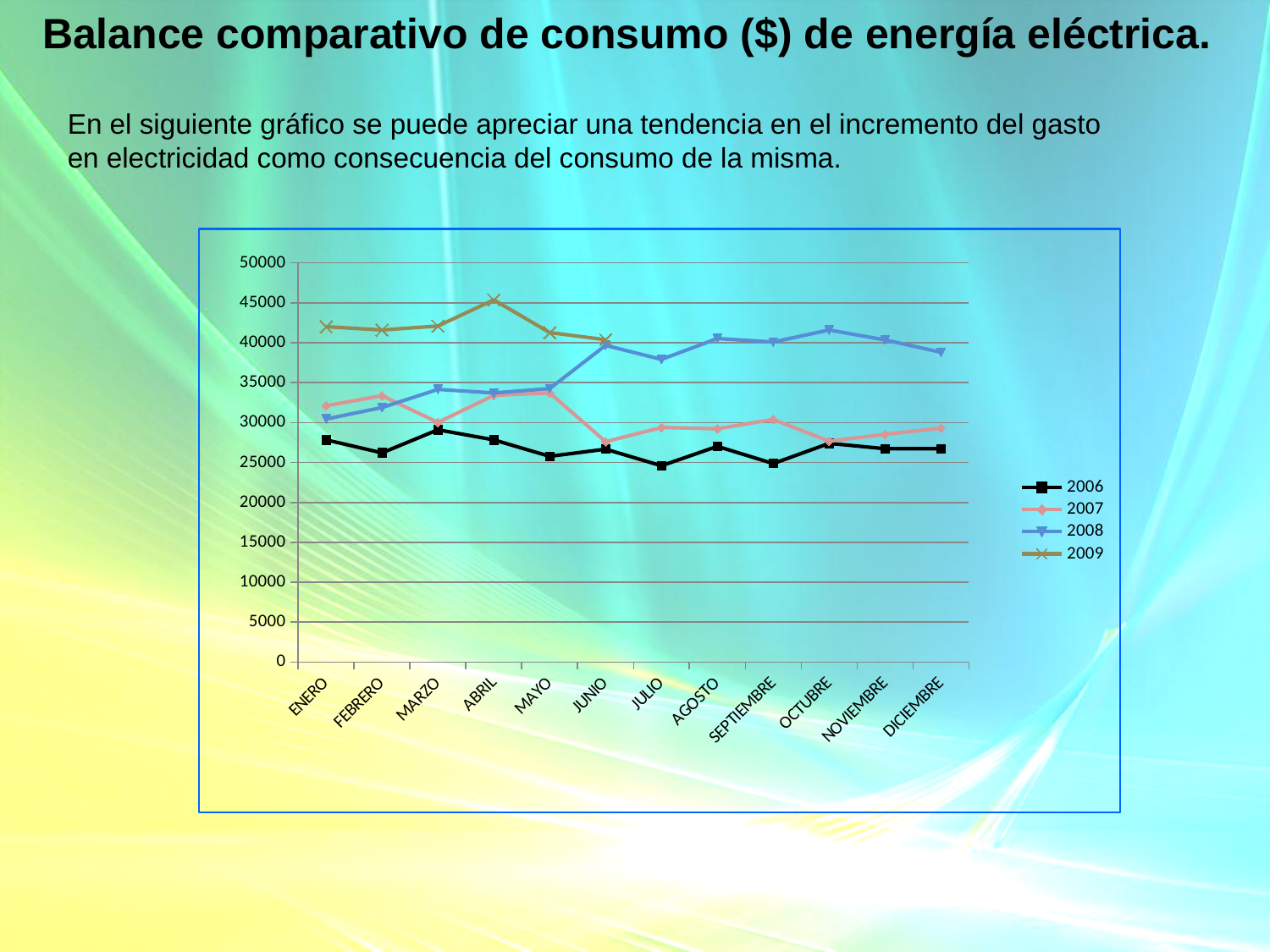
Is the value for 2008 in OCTUBRE greater or less than 40000? greater Is the value for 2007 in JUNIO greater or less than 30000? less Which series is drawn with x-shaped markers? 2009 Does the 2008 series generally rise or fall from ENERO to DICIEMBRE? Rise How many months are shown along the x axis? 12 In which month does the 2008 series have its lowest value? ENERO How many series does the legend list? 4 In which month does the 2009 series reach its highest value? ABRIL Which series has the highest value in ENERO? 2009 Which series has the lowest value in ENERO? 2006 What kind of chart is shown on the slide? Line chart In DICIEMBRE, which is larger: the 2008 value or the 2007 value? 2008